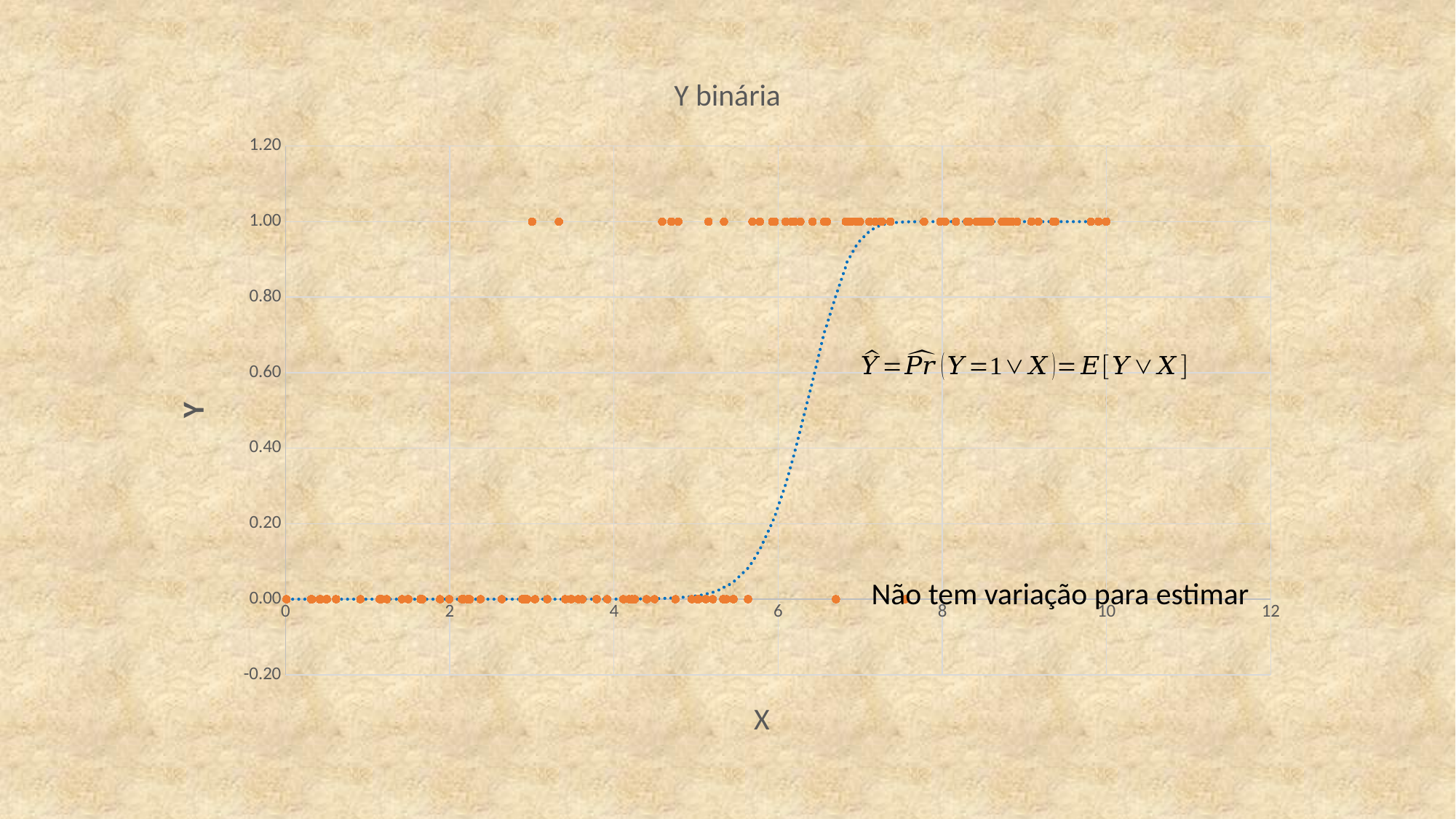
What is the title of the chart? Y binária Is the value of the dotted blue curve at X = 8 greater or less than 0.80? greater What is the label of the horizontal axis? X What are the two Y values that the orange data points take? 0.00 and 1.00 Is the value of the dotted blue curve at X = 6 greater or less than 0.40? less What kind of chart is shown on the slide? scatter chart Is the value of the dotted blue curve at X = 4 greater or less than 0.20? less Does the dotted blue curve rise or fall as X increases? rise Are the orange points at Y = 1.00 found mostly at larger or smaller X values than the points at Y = 0.00? larger What is the highest tick value shown on the X axis? 12 What is the highest tick value shown on the Y axis? 1.20 What is the lowest tick value shown on the Y axis? -0.20